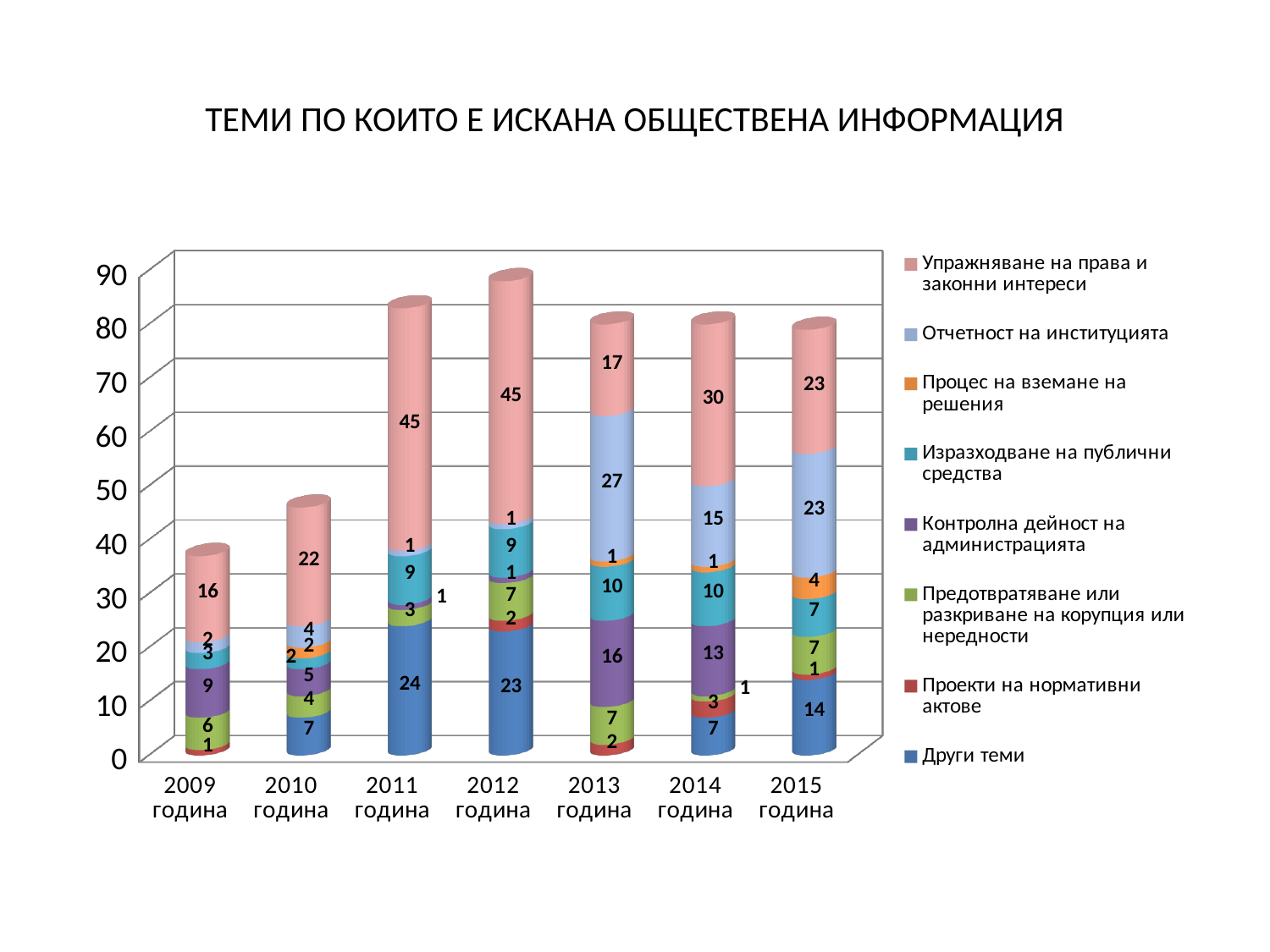
Which year has the larger value for Контролна дейност на администрацията, 2013 година or 2014 година? 2013 година What is the value for Отчетност на институцията in 2013 година? 27 What is the difference between the values for Упражняване на права и законни интереси in 2014 година and 2015 година? 7 Which year has the lowest total stacked bar? 2009 година What is the value for Други теми in 2011 година? 24 How many series does the legend list? 8 In which year is the value for Отчетност на институцията the highest? 2013 година What is the total of the stacked bar for 2013 година? 80 What is the value for Процес на вземане на решения in 2015 година? 4 How many years are shown on the x axis of the chart? 7 What kind of chart is shown on the slide? Stacked bar chart What is the value for Упражняване на права и законни интереси in 2012 година? 45